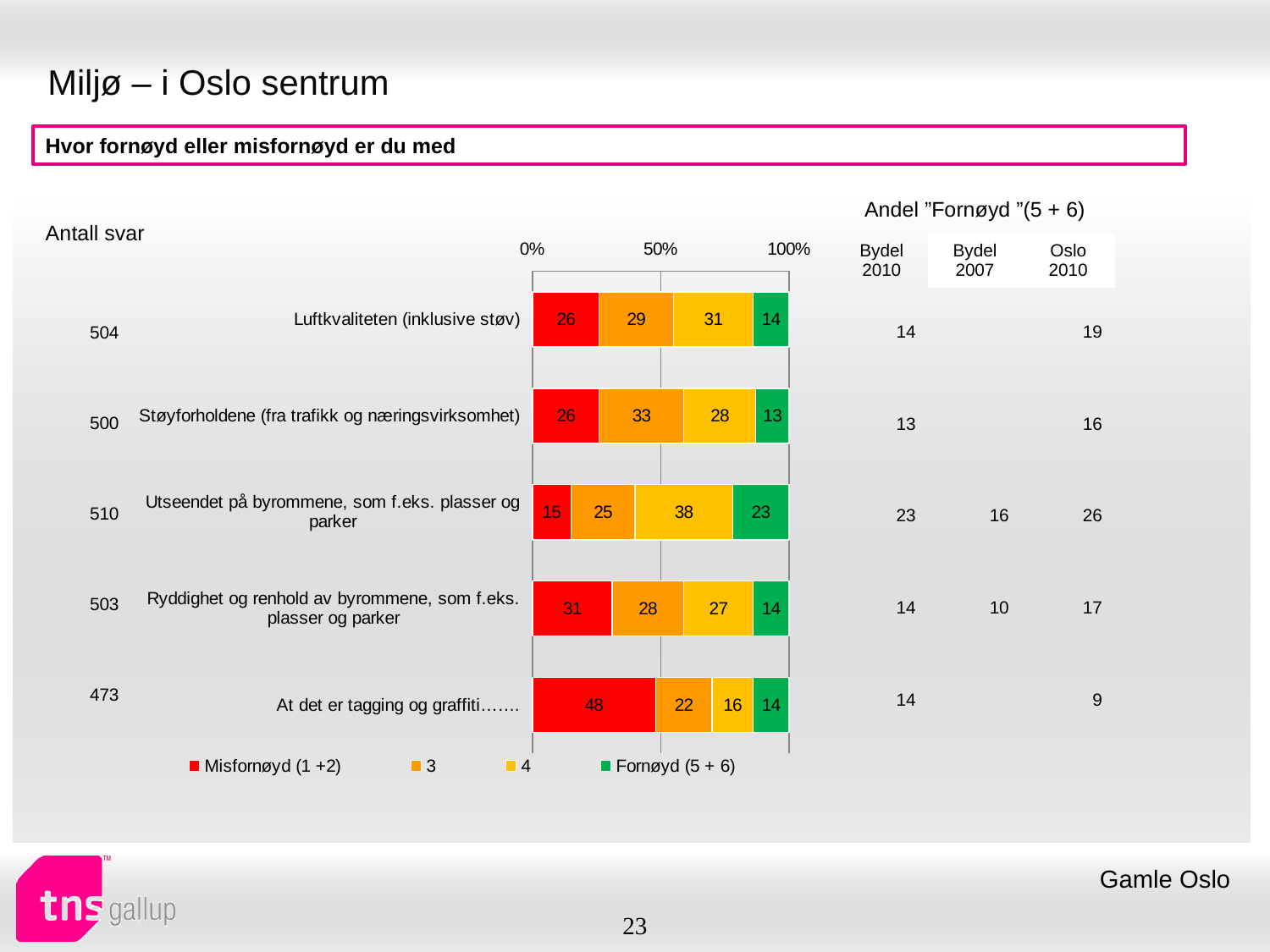
What is the Fornøyd (5 + 6) value for "Utseendet på byrommene, som f.eks. plasser og parker"? 23 Which category has the lowest Fornøyd (5 + 6) value? Støyforholdene (fra trafikk og næringsvirksomhet) Which is larger: the Misfornøyd (1 +2) value for "Ryddighet og renhold av byrommene, som f.eks. plasser og parker" or for "Luftkvaliteten (inklusive støv)"? Ryddighet og renhold av byrommene, som f.eks. plasser og parker What is the difference between the Misfornøyd (1 +2) values for "At det er tagging og graffiti……." and "Utseendet på byrommene, som f.eks. plasser og parker"? 33 What is the total of the stacked bar for "Luftkvaliteten (inklusive støv)"? 100 How many series does the legend list? 4 How many categories are shown in the chart? 5 What is the value of series "4" for "Luftkvaliteten (inklusive støv)"? 31 What is the Misfornøyd (1 +2) value for "At det er tagging og graffiti……."? 48 Which category has the highest Misfornøyd (1 +2) value? At det er tagging og graffiti……. What is the value of series "3" for "Støyforholdene (fra trafikk og næringsvirksomhet)"? 33 What kind of chart is shown on the slide? Stacked bar chart